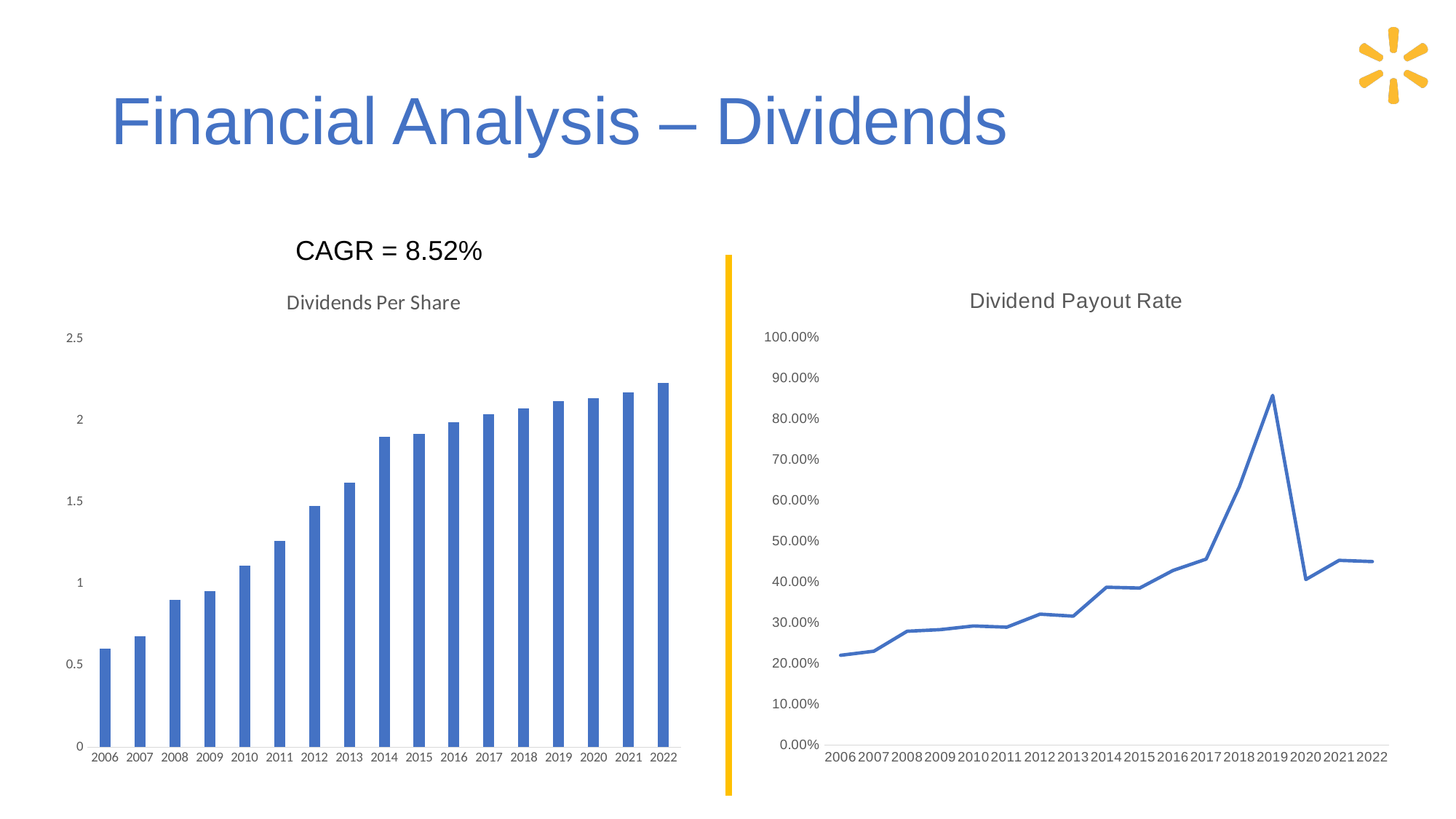
In the "Dividends Per Share" chart, is the value for 2022 greater or less than 2? greater In the "Dividend Payout Rate" chart, is the value for 2017 greater or less than 50.00%? less In the "Dividend Payout Rate" chart, is the value for 2019 greater or less than 80.00%? greater What CAGR is stated above the "Dividends Per Share" chart? 8.52% In the "Dividend Payout Rate" chart, which year has the highest payout rate? 2019 In the "Dividends Per Share" chart, which year has the lowest value? 2006 In the "Dividends Per Share" chart, which year has the highest value? 2022 What kind of chart is the "Dividend Payout Rate" chart? line chart What kind of chart is the "Dividends Per Share" chart? bar chart In the "Dividends Per Share" chart, how many years are shown on the x axis? 17 In the "Dividends Per Share" chart, do the values generally rise or fall from 2006 to 2022? rise